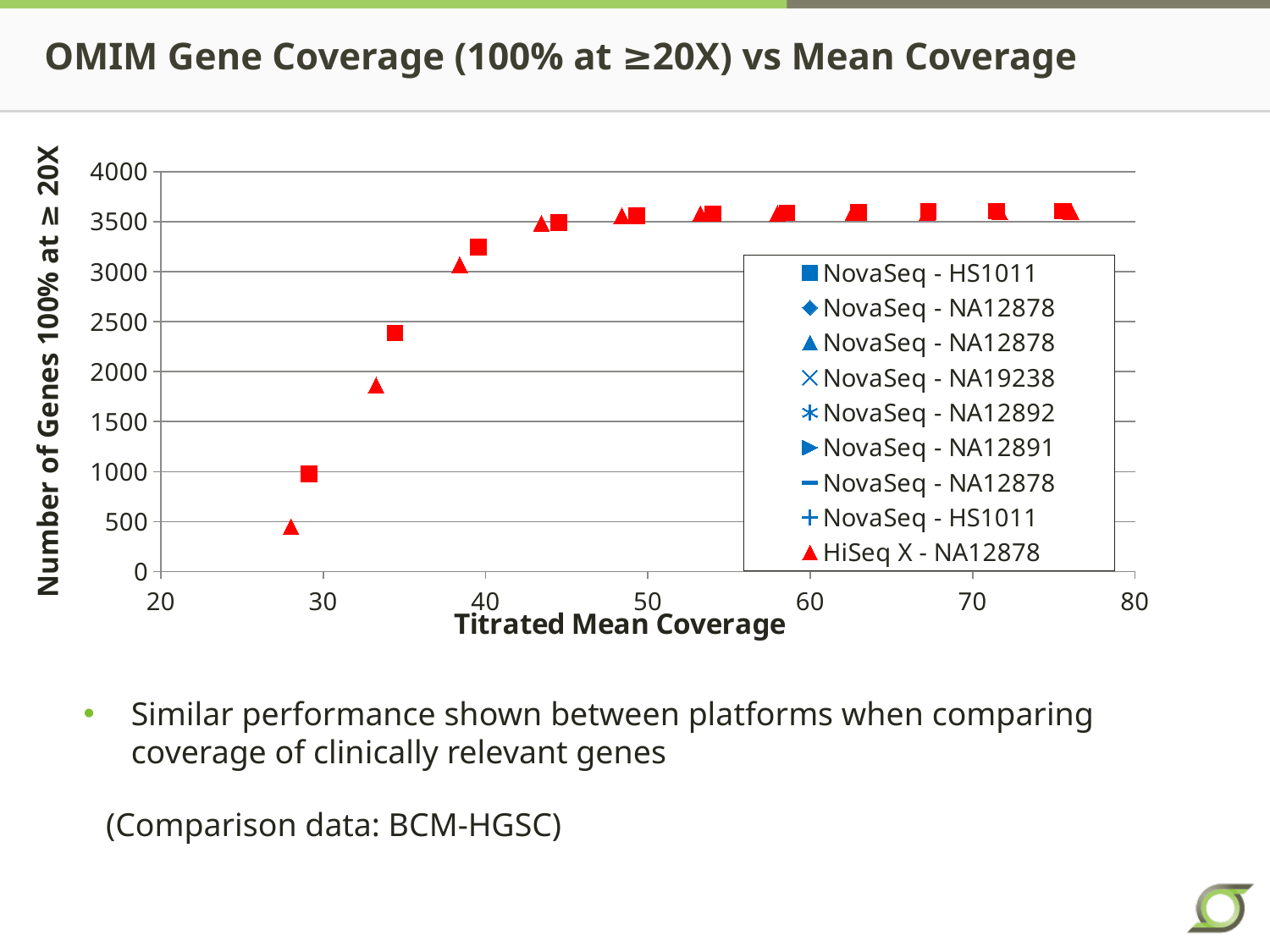
What is the title of the y axis of the chart? Number of Genes 100% at ≥ 20X What is the highest value shown on the y axis of the chart? 4000 Is the lowest plotted value on the chart greater or less than 1000? less Which is larger: the plotted value at a Titrated Mean Coverage of about 28 or the plotted value at about 40? The value at about 40 As Titrated Mean Coverage increases along the x axis, do the plotted values rise or fall? Rise Is the plotted value at a Titrated Mean Coverage of about 33 greater or less than 2500? less Is the plotted value at a Titrated Mean Coverage of about 35 greater or less than 2000? greater What kind of chart is shown on the slide? Scatter chart What is the title of the x axis of the chart? Titrated Mean Coverage How many series does the chart's legend list? 9